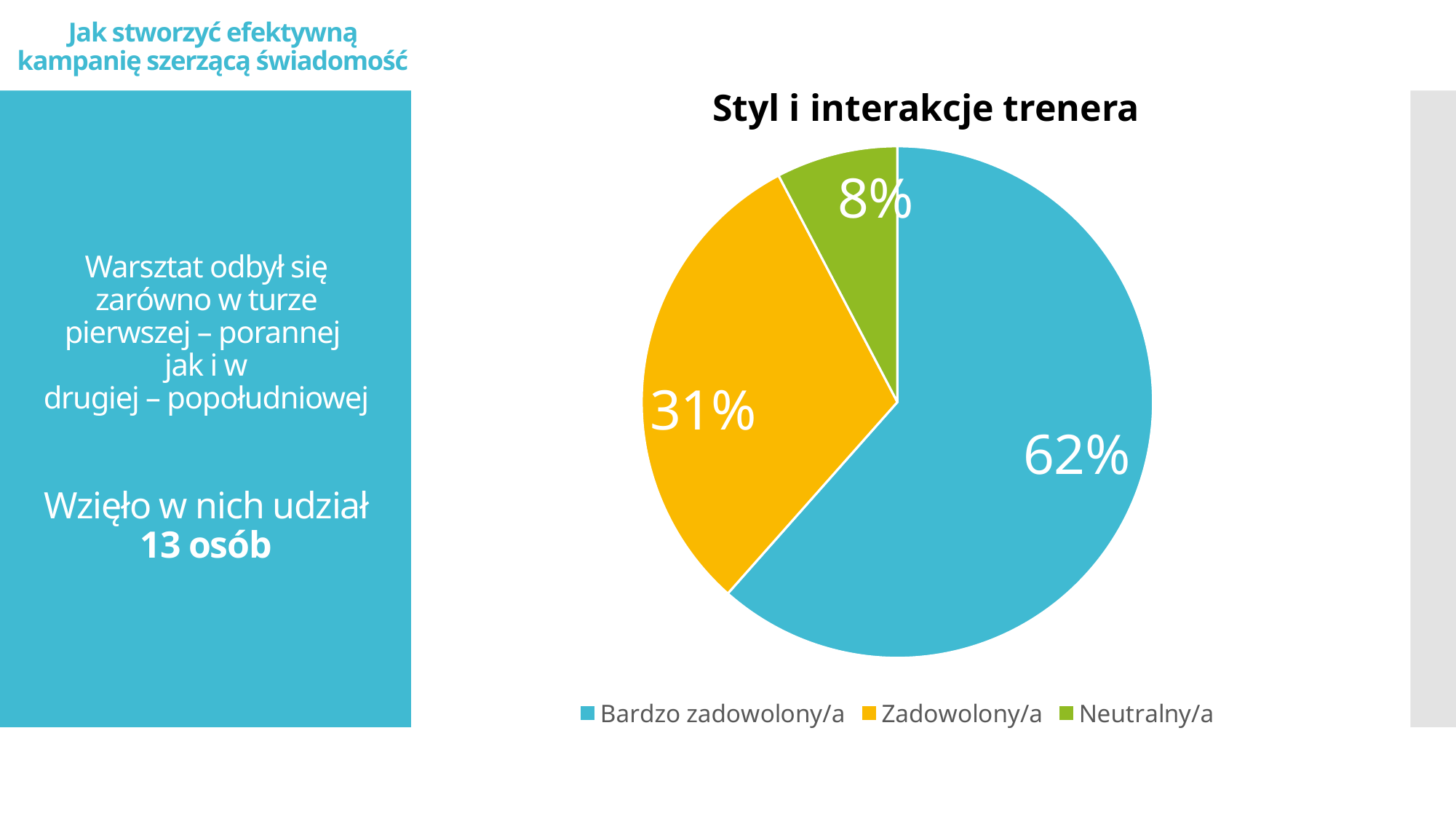
What is the difference in percentage points between Bardzo zadowolony/a and Zadowolony/a? 31 Which category has the smallest slice of the pie? Neutralny/a Which category has the largest slice of the pie? Bardzo zadowolony/a How many categories does the pie chart show? 3 What share of the pie is labelled Bardzo zadowolony/a? 62% How many entries does the legend list? 3 What share of the pie is labelled Neutralny/a? 8% What kind of chart is shown on the slide? pie chart Which is larger, the share for Zadowolony/a or the share for Neutralny/a? Zadowolony/a What colour is the Neutralny/a slice? green What share of the pie is labelled Zadowolony/a? 31% What is the title of the chart? Styl i interakcje trenera